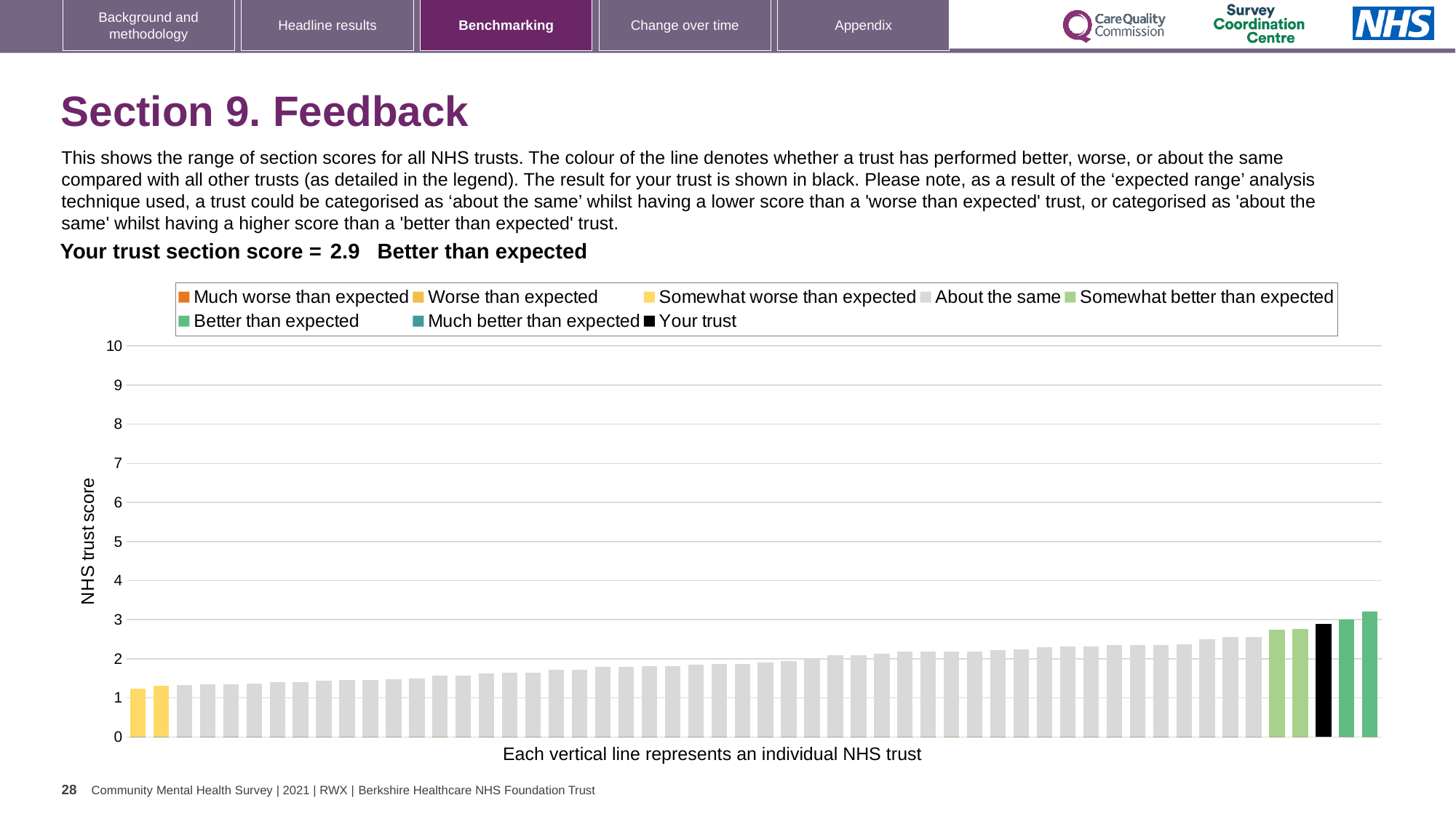
Which benchmarking category is your trust's section score placed in? Better than expected What colour is the bar representing your trust? Black What kind of chart is shown on the slide? Bar chart Is your trust's bar higher or lower than the tallest bar on the chart? lower Is the value for your trust greater or less than 5? less What is the label on the vertical axis of the chart? NHS trust score Is the value for your trust greater or less than 2? greater How many entries does the chart legend list? 8 Is the value for the lowest-scoring trust greater or less than 2? less Do the bar values rise or fall from left to right along the x axis? rise What is the section score for your trust? 2.9